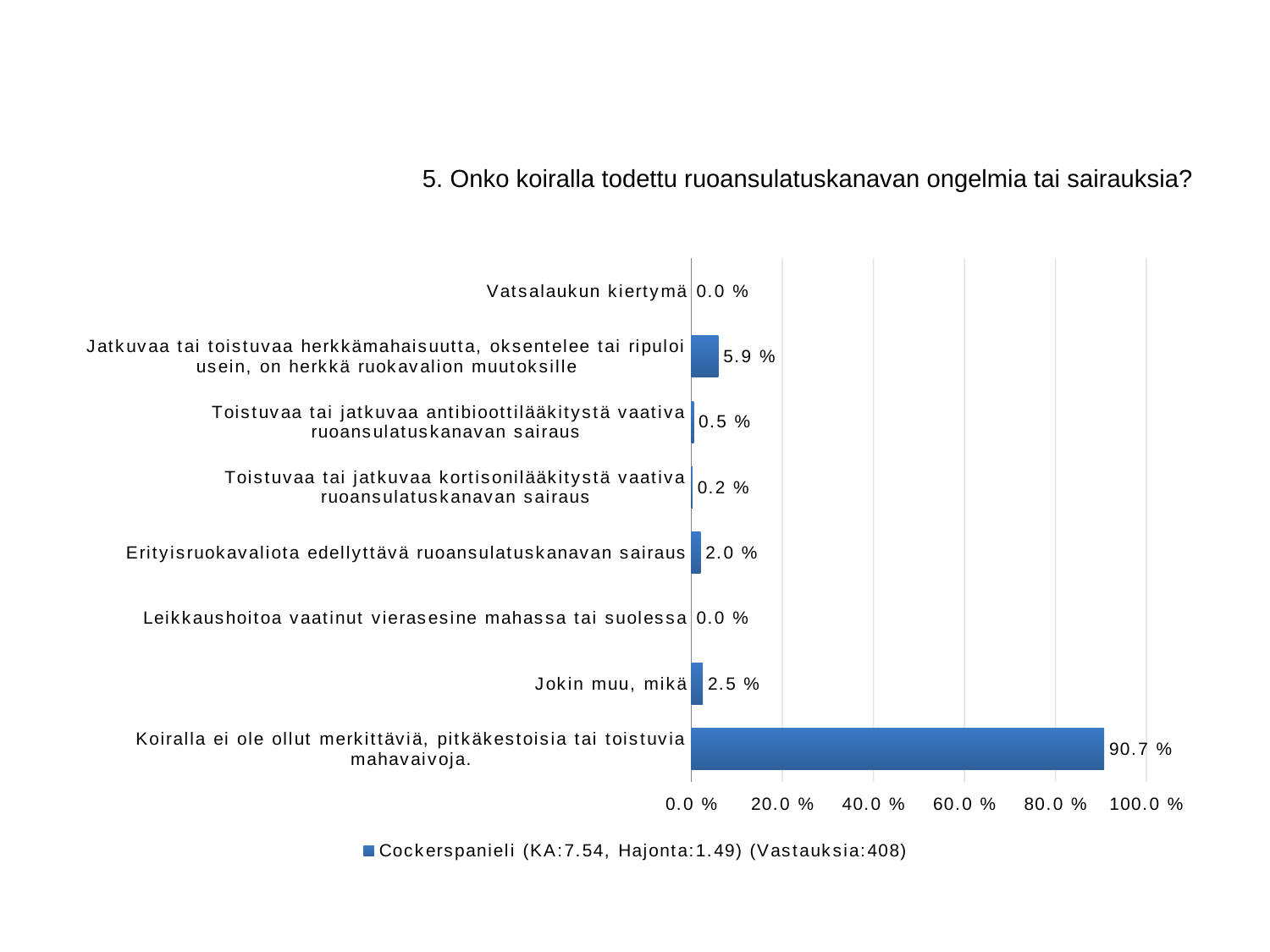
Which category has the highest value? Koiralla ei ole ollut merkittäviä, pitkäkestoisia tai toistuvia mahavaivoja. What is the difference between the values for "Jatkuvaa tai toistuvaa herkkämahaisuutta, oksentelee tai ripuloi usein, on herkkä ruokavalion muutoksille" and "Jokin muu, mikä"? 3.4 % What kind of chart is shown on the slide? bar chart What is the value for "Erityisruokavaliota edellyttävä ruoansulatuskanavan sairaus"? 2.0 % What is the value for "Jatkuvaa tai toistuvaa herkkämahaisuutta, oksentelee tai ripuloi usein, on herkkä ruokavalion muutoksille"? 5.9 % What is the value for "Koiralla ei ole ollut merkittäviä, pitkäkestoisia tai toistuvia mahavaivoja."? 90.7 % Is the value for "Koiralla ei ole ollut merkittäviä, pitkäkestoisia tai toistuvia mahavaivoja." greater or less than 80.0 %? greater Which is larger: the value for "Toistuvaa tai jatkuvaa antibioottilääkitystä vaativa ruoansulatuskanavan sairaus" or for "Erityisruokavaliota edellyttävä ruoansulatuskanavan sairaus"? Erityisruokavaliota edellyttävä ruoansulatuskanavan sairaus What is the value for "Jokin muu, mikä"? 2.5 % What is the value for "Toistuvaa tai jatkuvaa kortisonilääkitystä vaativa ruoansulatuskanavan sairaus"? 0.2 % How many responses (Vastauksia) does the legend report? 408 How many categories are shown in the chart? 8